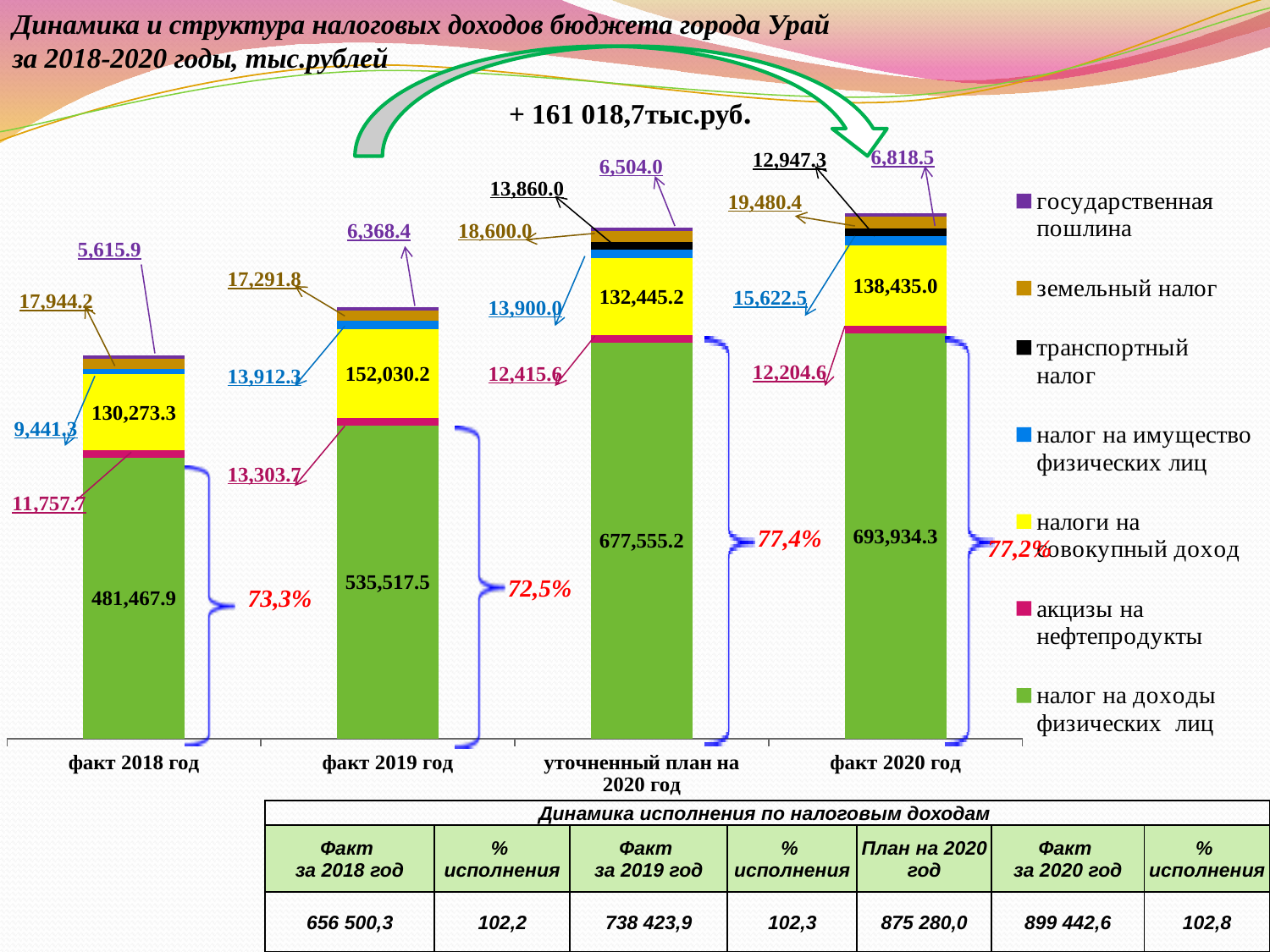
Which category has the highest value for налог на доходы физических лиц? факт 2020 год Does the value of налог на доходы физических лиц rise or fall from факт 2018 год to факт 2020 год? rises What is the value of земельный налог for факт 2020 год? 19,480.4 Which category has the lowest value for налоги на совокупный доход? факт 2018 год What kind of chart is shown on the slide? stacked bar chart How many categories are shown on the x axis of the chart? 4 What is the value of налоги на совокупный доход for факт 2019 год? 152,030.2 What is the difference between налог на доходы физических лиц for факт 2020 год and уточненный план на 2020 год? 16,379.1 What is the value of государственная пошлина for уточненный план на 2020 год? 6,504.0 What is the value of налог на доходы физических лиц for факт 2018 год? 481,467.9 How many series does the legend list? 7 Which is larger for акцизы на нефтепродукты: факт 2018 год or факт 2019 год? факт 2019 год